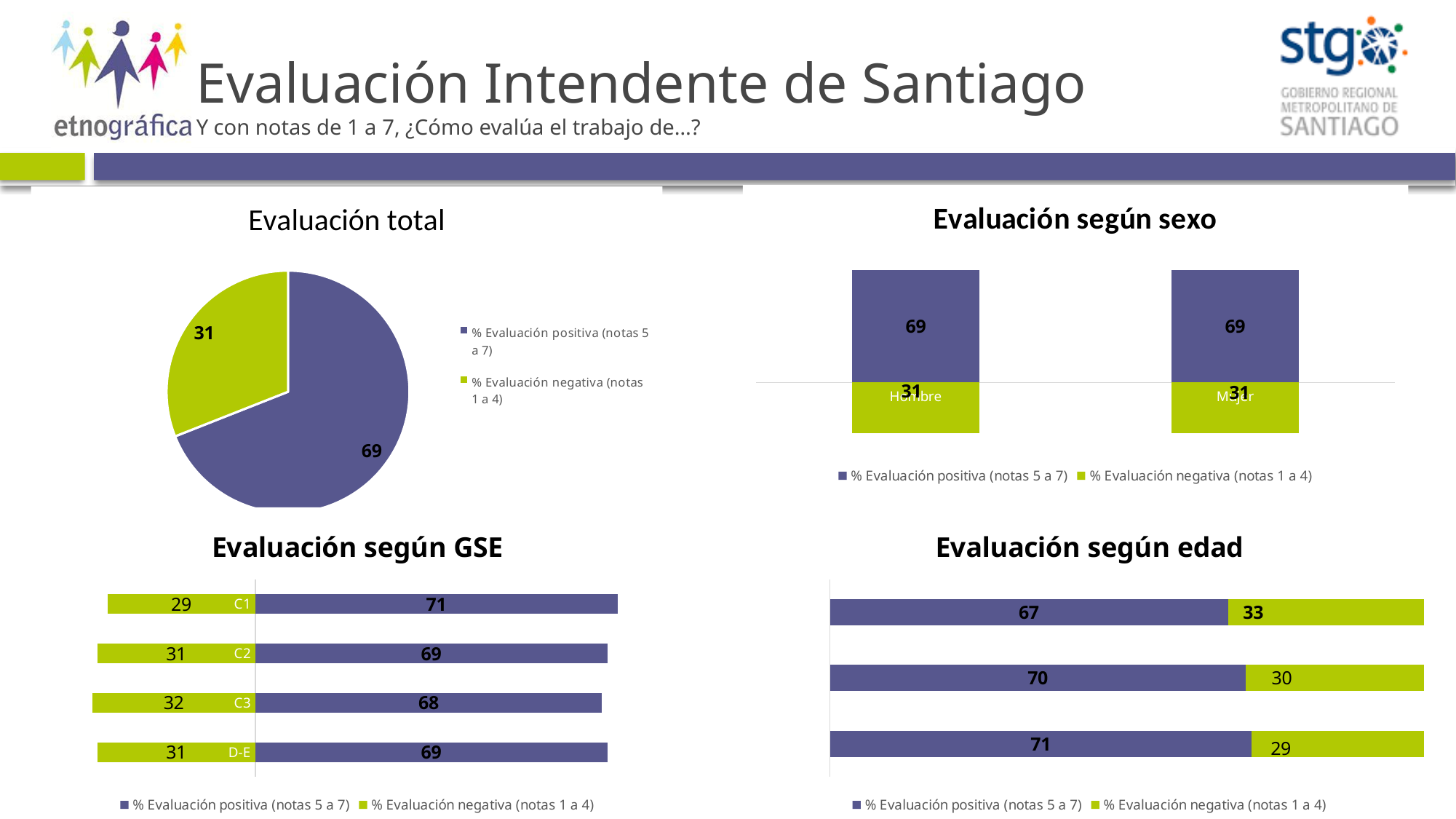
In the 'Evaluación según GSE' chart, which category has the lowest positive evaluation value? C3 How many series does the legend of the 'Evaluación según edad' chart list? 2 In the 'Evaluación según GSE' chart, which category has the highest positive evaluation value? C1 In the 'Evaluación total' chart, what value is shown for '% Evaluación positiva (notas 5 a 7)'? 69 What kind of chart is 'Evaluación total'? Pie chart How many categories are shown in the 'Evaluación según GSE' chart? 4 In the 'Evaluación según edad' chart, what is the highest positive evaluation value shown? 71 In the 'Evaluación según sexo' chart, what is the negative evaluation value for Hombre? 31 In the 'Evaluación total' chart, what value is shown for '% Evaluación negativa (notas 1 a 4)'? 31 In the 'Evaluación según GSE' chart, what is the difference between the positive evaluation values for C1 and C3? 3 In the 'Evaluación según GSE' chart, what is the negative evaluation value for D-E? 31 In the 'Evaluación según sexo' chart, what is the positive evaluation value for Mujer? 69